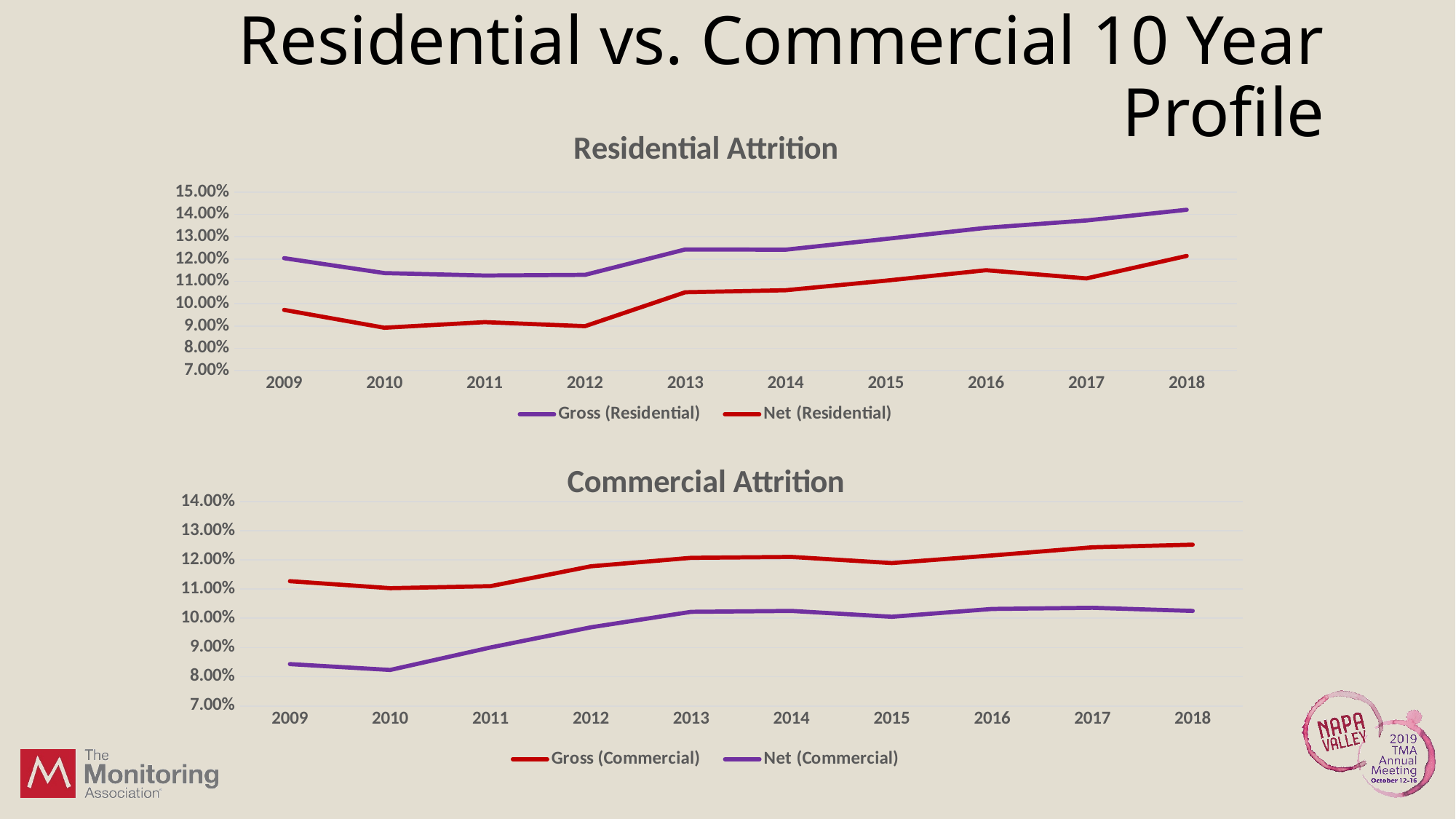
In the Commercial Attrition chart, is the Net (Commercial) value for 2009 greater or less than 9.00%? less In the Commercial Attrition chart, what colour is the Gross (Commercial) line? red In the Commercial Attrition chart, is the Gross (Commercial) value for 2009 greater or less than 11.00%? greater What type of chart is the Residential Attrition chart? line chart How many series does the legend of the Commercial Attrition chart list? 2 In the Residential Attrition chart, is the Gross (Residential) value for 2018 greater or less than 14.00%? greater How many years are plotted on the x axis of the Residential Attrition chart? 10 In the Commercial Attrition chart, does the Net (Commercial) line generally rise or fall from 2009 to 2018? rise In the Commercial Attrition chart, which year has the lowest Net (Commercial) value? 2010 In the Residential Attrition chart, which series is higher in 2015, Gross (Residential) or Net (Residential)? Gross (Residential) In the Residential Attrition chart, which year has the highest Gross (Residential) value? 2018